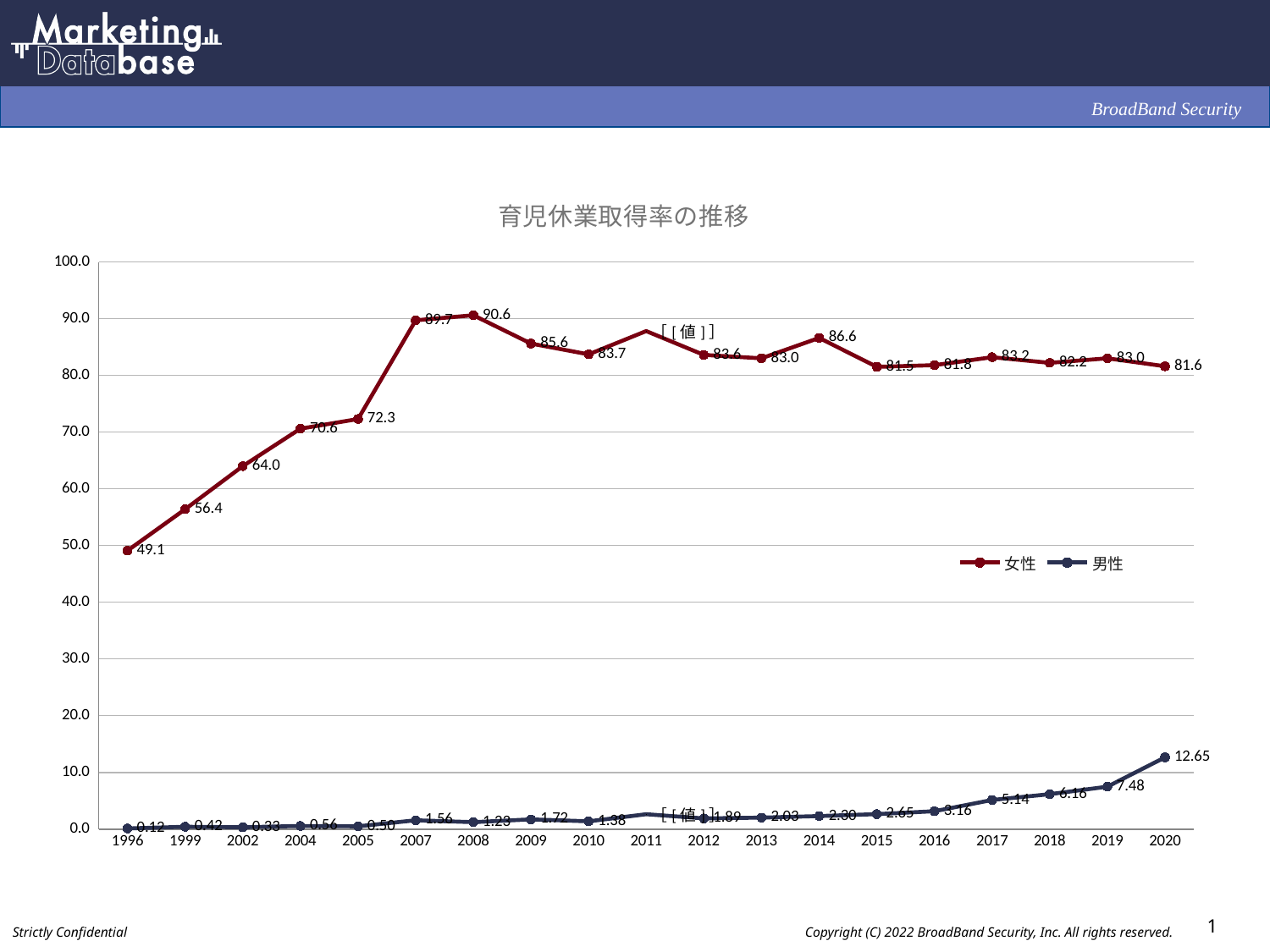
What is the value for 女性 in 2008? 90.6 In which year is the 女性 series at its lowest? 1996 How many series does the legend list? 2 What is the value for 男性 in 2020? 12.65 What kind of chart is shown on the slide? line chart How many years are plotted along the x axis? 19 What is the title of the chart? 育児休業取得率の推移 In which year is the 男性 series at its highest? 2020 Which is larger for 女性: the value in 2014 or the value in 2015? 2014 What is the difference between the 女性 value in 2020 and in 1996? 32.5 Is the value for 女性 in 2011 greater or less than 80.0? greater What is the value for 女性 in 1996? 49.1